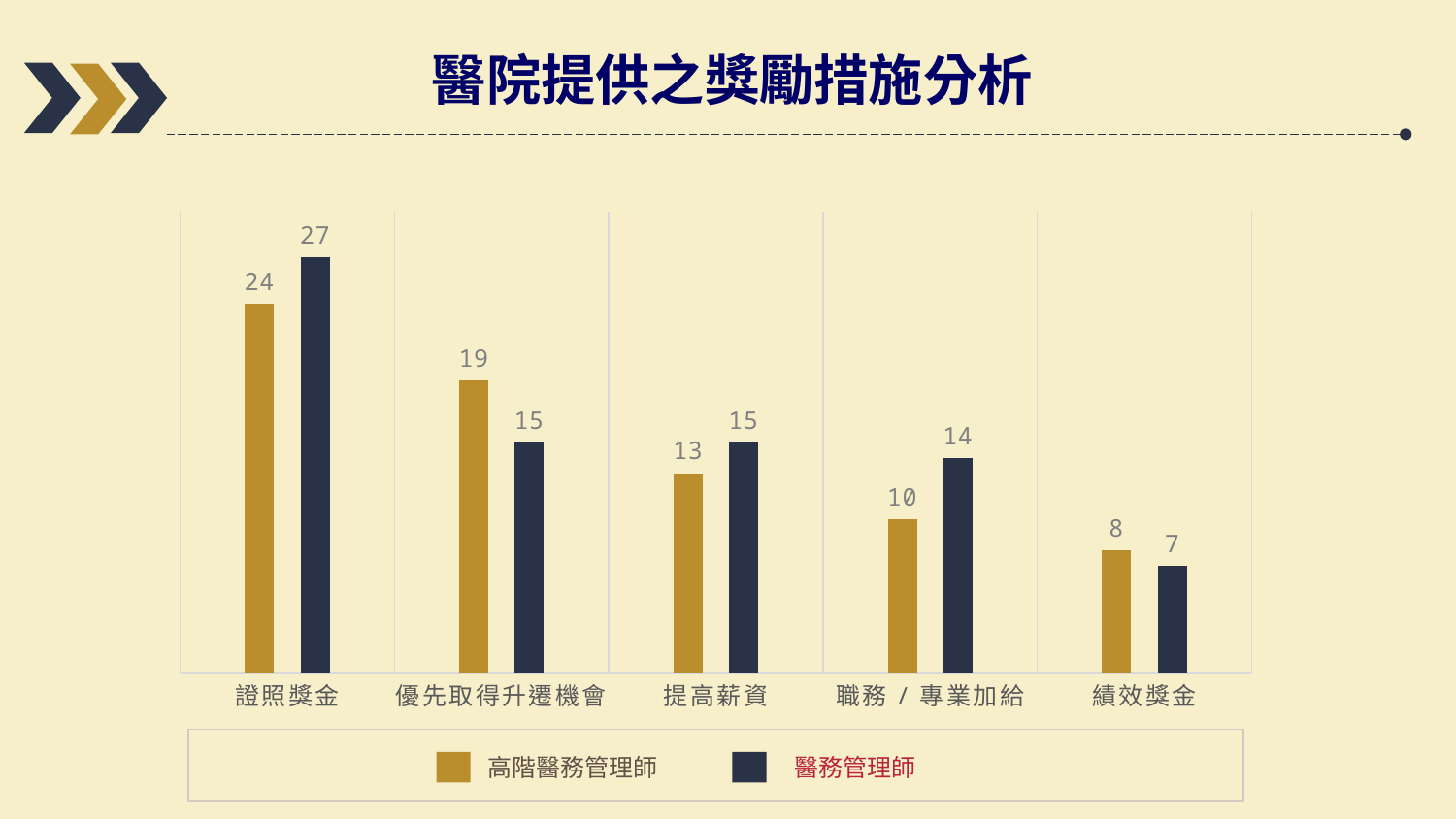
What is the value for 醫務管理師 in the 優先取得升遷機會 category? 15 Which category has the highest value for 醫務管理師? 證照獎金 How many categories are shown on the x axis? 5 What is the difference between the 高階醫務管理師 and 醫務管理師 values in the 優先取得升遷機會 category? 4 What is the value for 高階醫務管理師 in the 證照獎金 category? 24 What kind of chart is shown on the slide? Bar chart What is the difference between the 醫務管理師 and 高階醫務管理師 values in the 證照獎金 category? 3 What is the value for 高階醫務管理師 in the 職務 / 專業加給 category? 10 In the 績效獎金 category, which series has the larger value, 高階醫務管理師 or 醫務管理師? 高階醫務管理師 Which category has the lowest value for 高階醫務管理師? 績效獎金 In the 提高薪資 category, which series has the larger value, 高階醫務管理師 or 醫務管理師? 醫務管理師 How many series does the legend list? 2